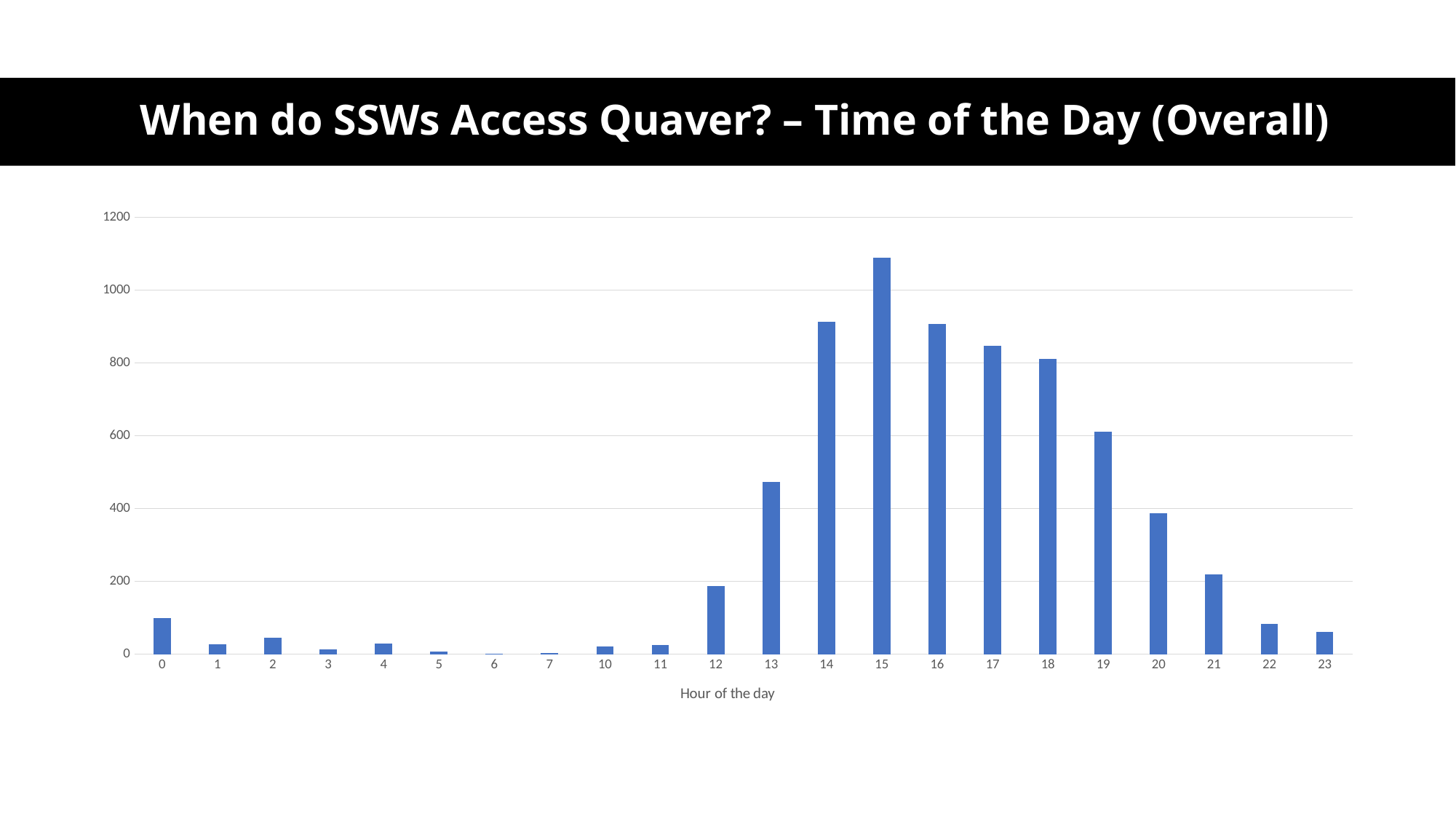
Is the value for hour 15 greater or less than 1000? greater What kind of chart is shown on the slide? bar chart Which hour of the day has the highest bar? 15 How many hour categories are shown on the x axis? 22 Do the values rise or fall from hour 15 to hour 23? fall Is the value for hour 13 greater or less than 400? greater Which has the larger value, hour 13 or hour 19? 19 Is the value for hour 14 greater or less than 800? greater What is the title of the slide's chart? When do SSWs Access Quaver? – Time of the Day (Overall) What is the label on the x axis of the chart? Hour of the day